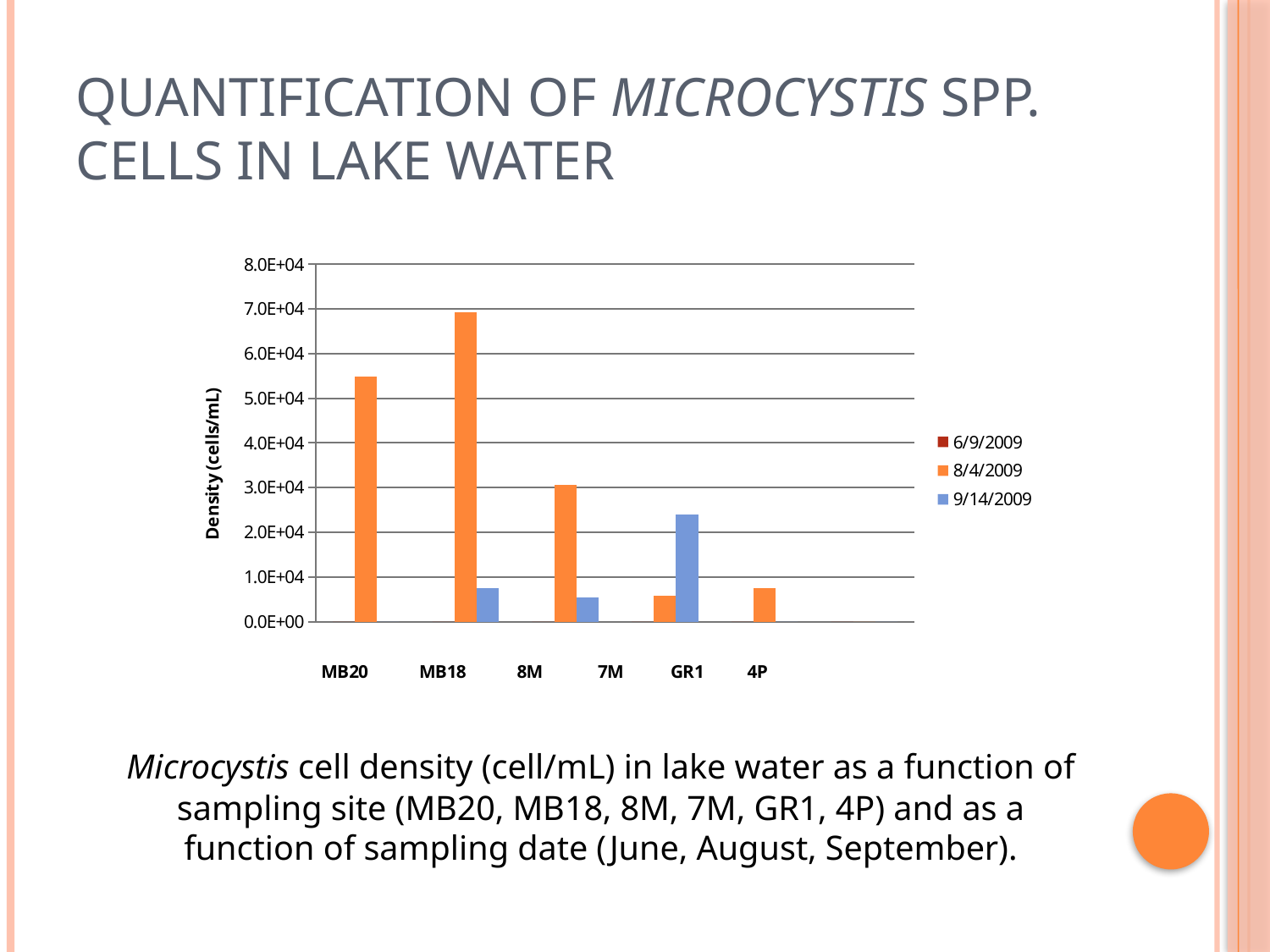
For 7M, which series has the larger value, 8/4/2009 or 9/14/2009? 9/14/2009 Is the 9/14/2009 value for MB18 greater or less than 1.0E+04? less What is the label of the y axis? Density (cells/mL) How many series does the legend list? 3 Is the 8/4/2009 value for MB20 greater or less than 5.0E+04? greater Is the 9/14/2009 value for 7M greater or less than 2.0E+04? greater How many sampling sites are shown on the x axis? 6 What kind of chart is shown on the slide? bar chart Which sampling site has the highest 8/4/2009 bar? MB18 Which is larger, the 8/4/2009 value for MB20 or the 8/4/2009 value for 8M? MB20